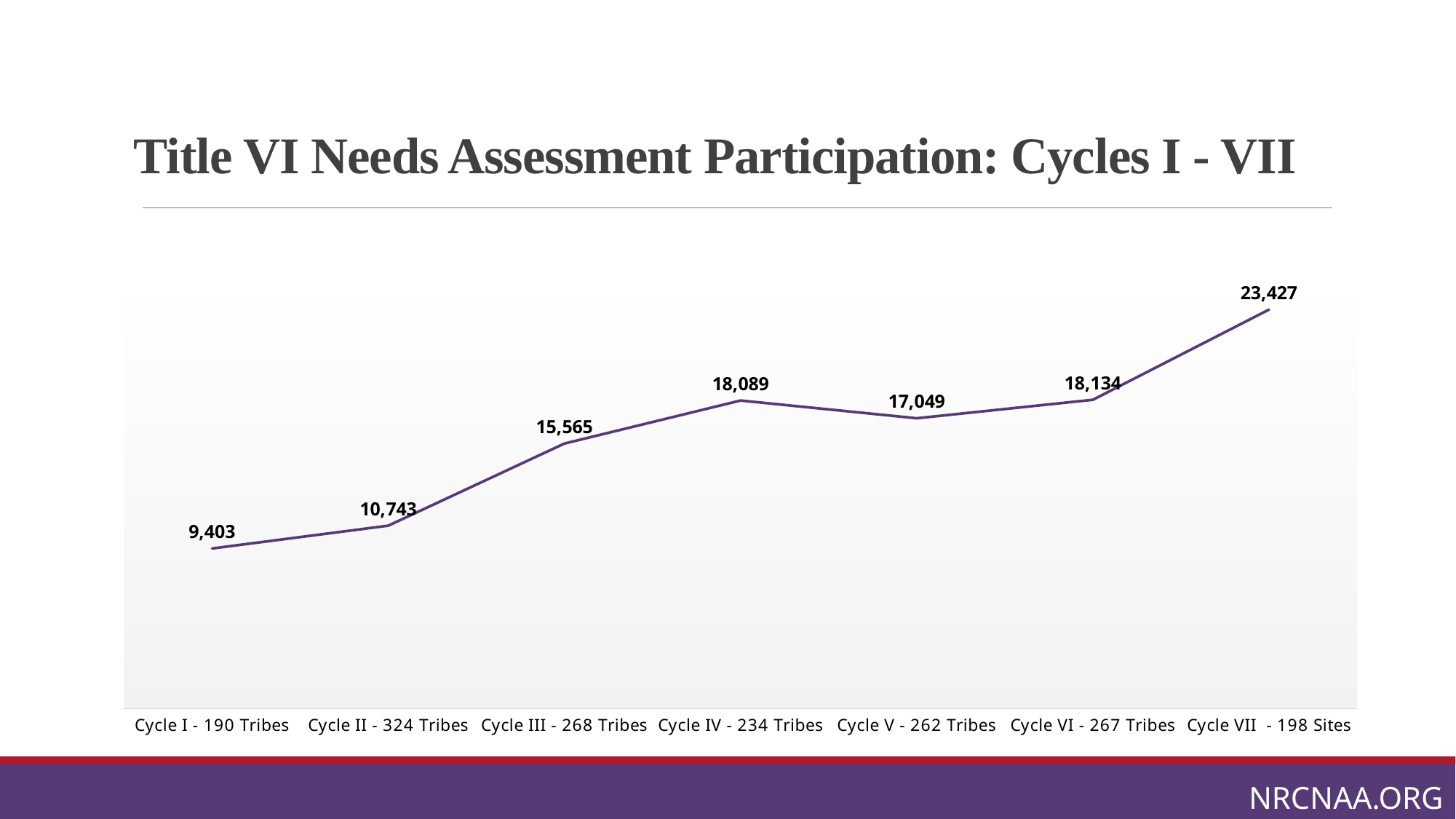
Which is larger, the value for Cycle IV - 234 Tribes or Cycle V - 262 Tribes? Cycle IV - 234 Tribes What is the difference between the values for Cycle III - 268 Tribes and Cycle II - 324 Tribes? 4,822 How many cycles are plotted on the chart? 7 What is the value for Cycle IV - 234 Tribes? 18,089 Does the value rise or fall from Cycle IV - 234 Tribes to Cycle V - 262 Tribes? Fall What kind of chart is shown on the slide? Line chart Which cycle has the lowest value? Cycle I - 190 Tribes Which cycle has the highest value? Cycle VII - 198 Sites What is the title of the chart? Title VI Needs Assessment Participation: Cycles I - VII What is the difference between the values for Cycle VII - 198 Sites and Cycle VI - 267 Tribes? 5,293 What is the value for Cycle VII - 198 Sites? 23,427 What is the value for Cycle I - 190 Tribes? 9,403